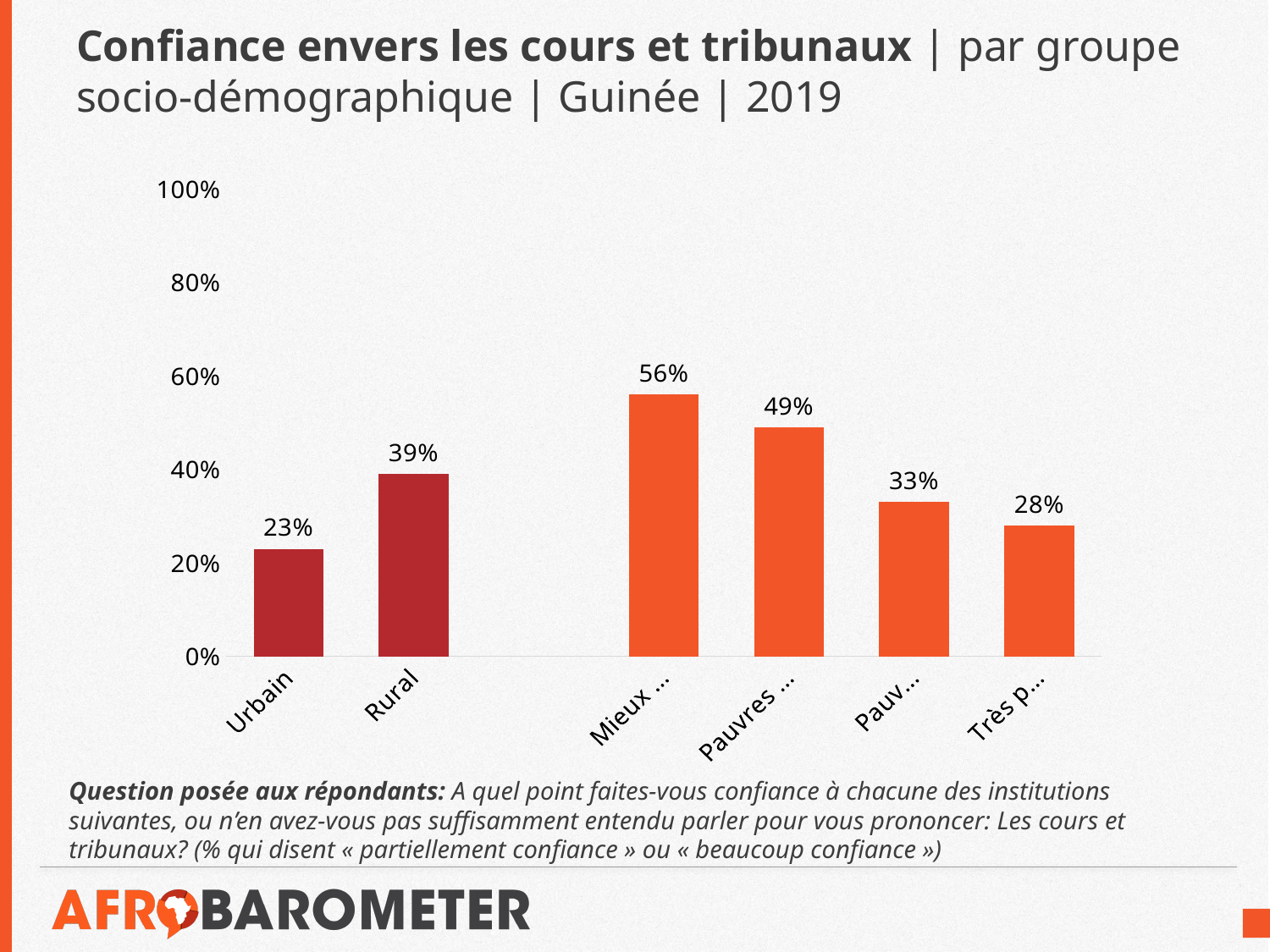
What is the value for Urbain? 23% What is the difference between the values for Rural and Urbain? 16% What is the value of the first orange bar (labelled 'Mieux ...')? 56% What is the highest value shown on the chart? 56% How many bars are shown on the chart? 6 What is the value for Rural? 39% What country and year does the chart title refer to? Guinée, 2019 Which is larger, the value for Urbain or the value for Rural? Rural What kind of chart is shown on the slide? bar chart Which category has the lowest value? Urbain Is the value for Rural greater or less than 20%? greater Do the values of the four orange bars rise or fall from left to right? fall